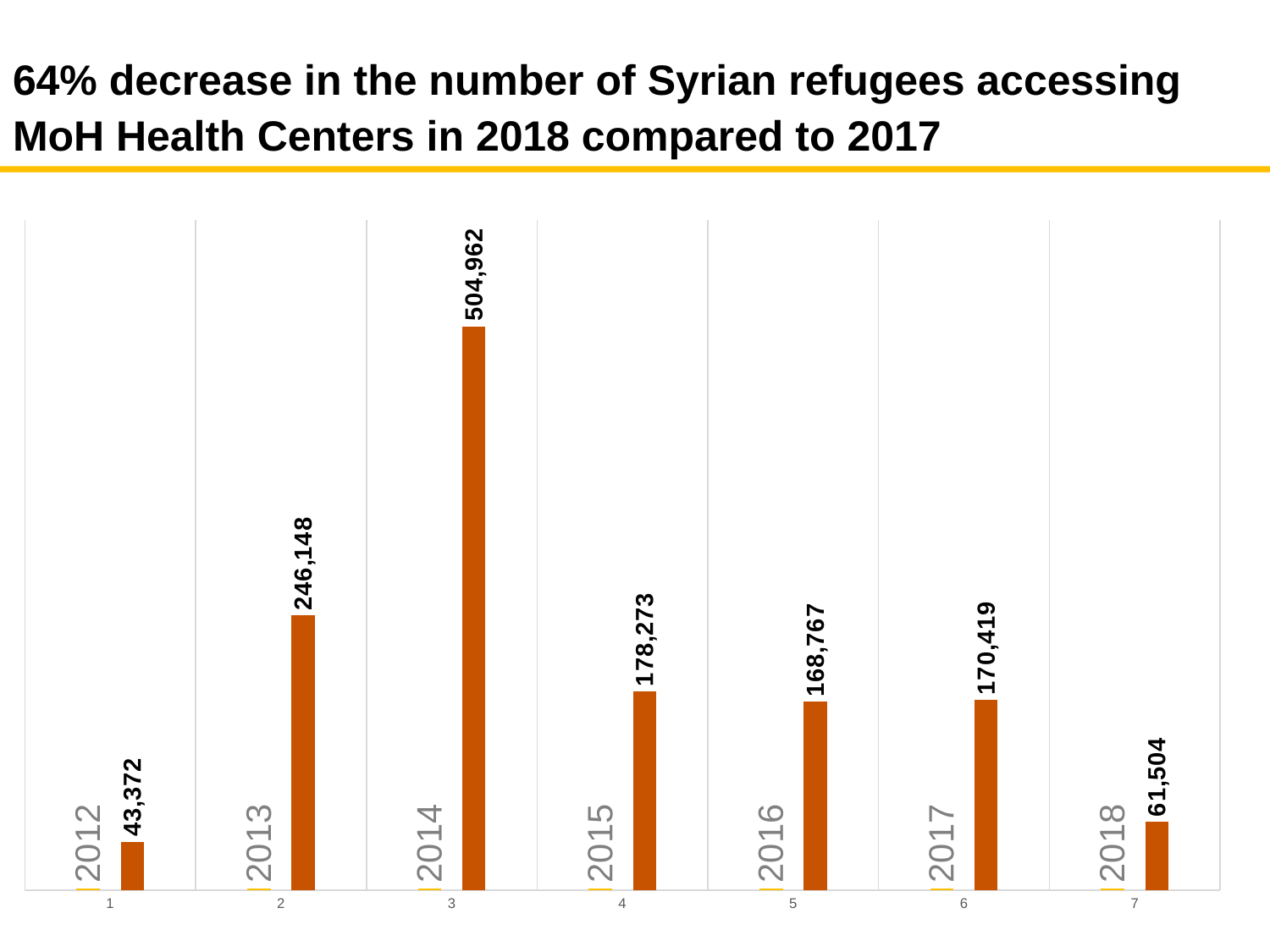
What is the number of Syrian refugees accessing MoH Health Centers in 2014? 504,962 What is the value shown for 2018? 61,504 How many years are shown on the chart? 7 What kind of chart is shown on the slide? Bar chart What is the difference between the values for 2014 and 2013? 258,814 What is the difference between the values for 2017 and 2018? 108,915 Do the values rise or fall from 2014 to 2015? Fall Which year has the lowest value? 2012 Which year has the highest value? 2014 What is the value shown for 2012? 43,372 Which is larger, the value for 2013 or the value for 2015? 2013 What is the value shown for 2017? 170,419